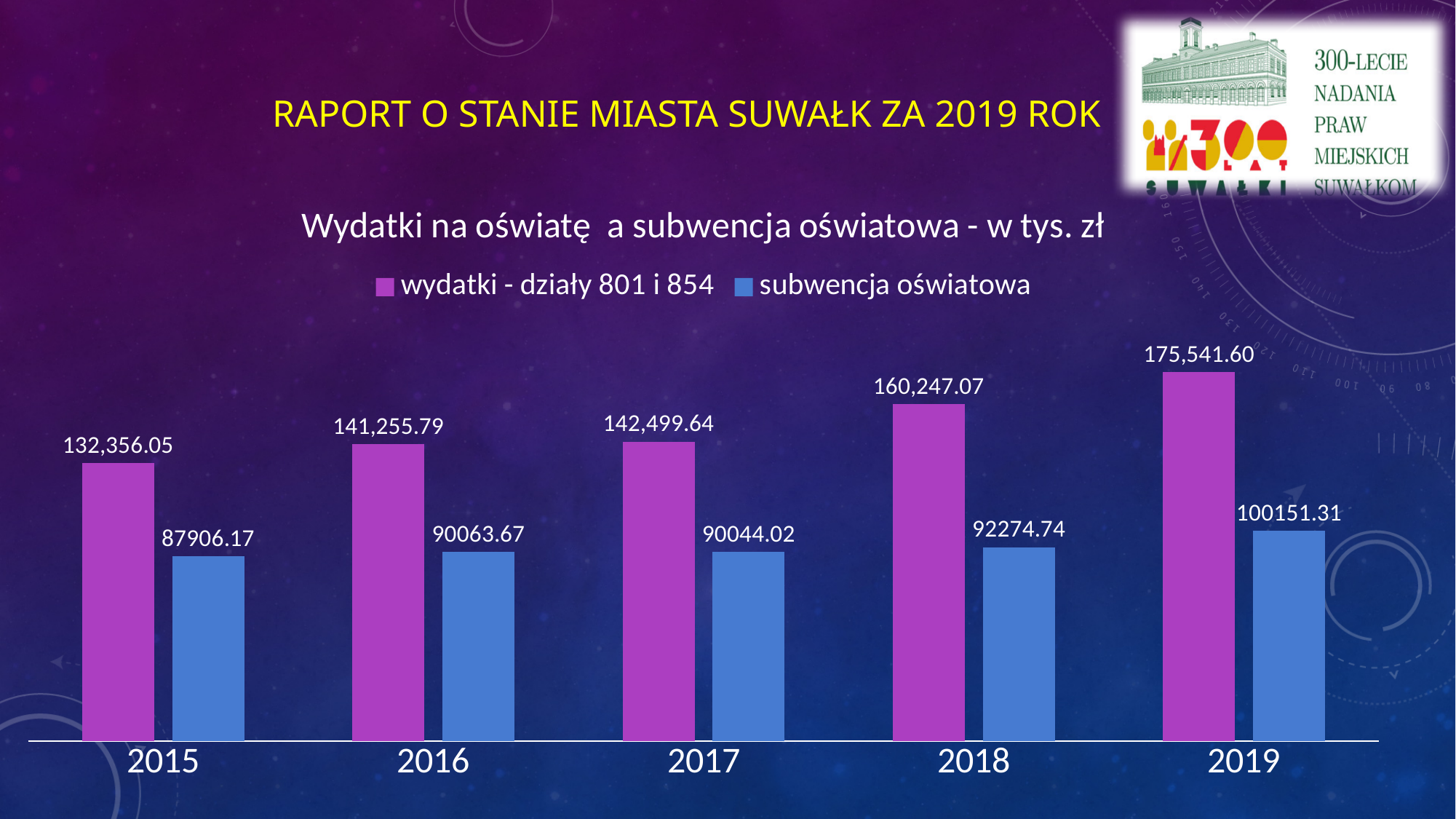
What is the value of 'subwencja oświatowa' for 2018? 92274.74 By how much did 'wydatki - działy 801 i 854' increase from 2018 to 2019? 15,294.53 In which year is 'subwencja oświatowa' the lowest? 2015 What is the value of 'wydatki - działy 801 i 854' for 2017? 142,499.64 How many series does the legend list? 2 What is the value of 'wydatki - działy 801 i 854' for 2019? 175,541.60 Does 'wydatki - działy 801 i 854' rise or fall from 2015 to 2019? rise What is the value of 'subwencja oświatowa' for 2015? 87906.17 What is the difference between 'wydatki - działy 801 i 854' and 'subwencja oświatowa' in 2019? 75,390.29 How many years are shown on the x axis? 5 Which is larger in 2016: 'wydatki - działy 801 i 854' or 'subwencja oświatowa'? wydatki - działy 801 i 854 In which year is 'wydatki - działy 801 i 854' the highest? 2019